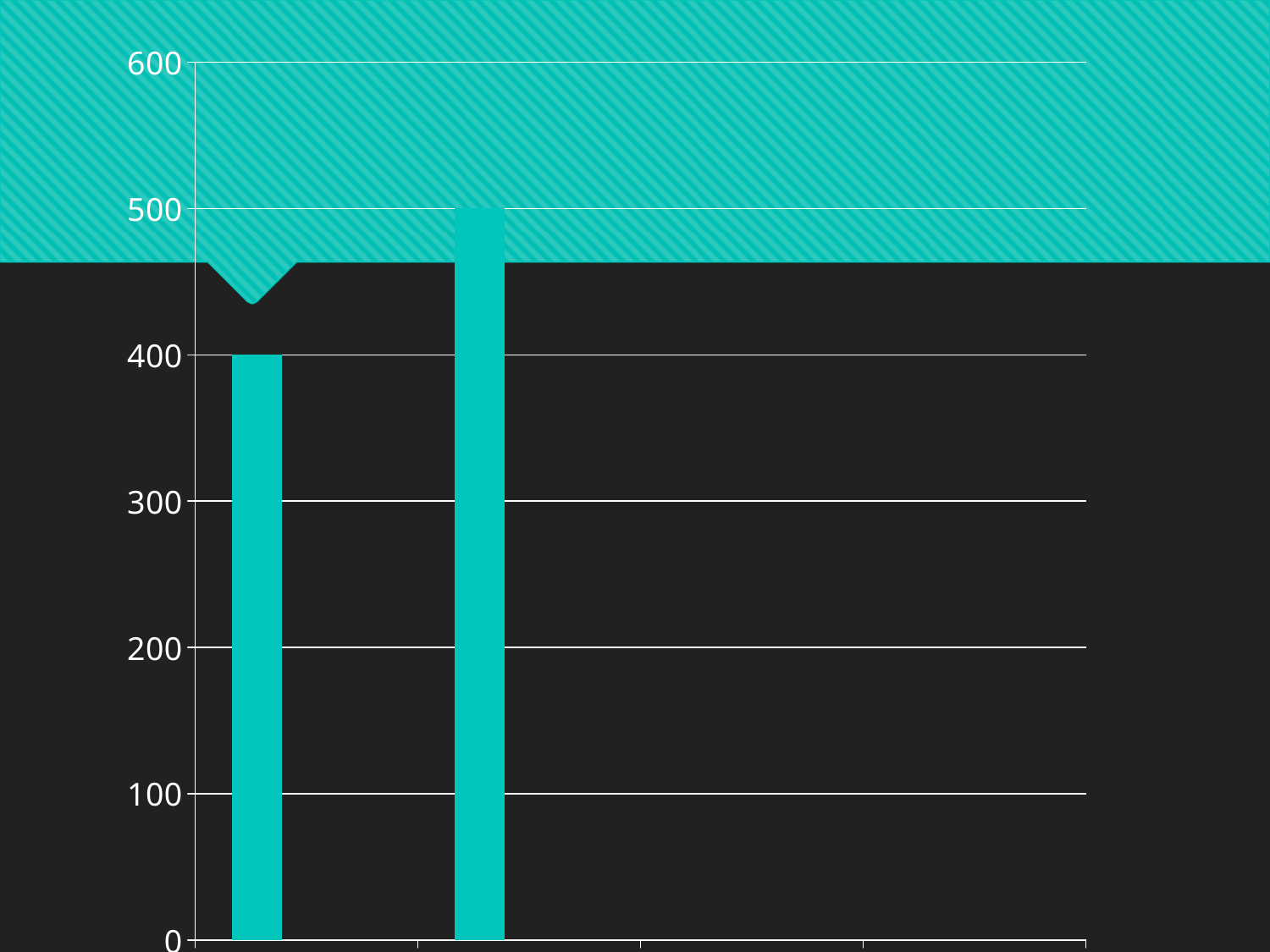
Is the value of the left bar greater or less than 300? greater Is the value of the right bar greater or less than 600? less What kind of chart is shown on the slide? bar chart What value does the left bar reach on the vertical axis? 400 Which bar has the lowest value? the left bar What is the difference between the right bar's value and the left bar's value? 100 What is the highest value labelled on the vertical axis? 600 What colour are the bars in the chart? teal Do the bar values rise or fall from left to right? rise How many bars are plotted in the chart? 2 Which bar is taller, the left bar or the right bar? the right bar What value does the right bar reach on the vertical axis? 500